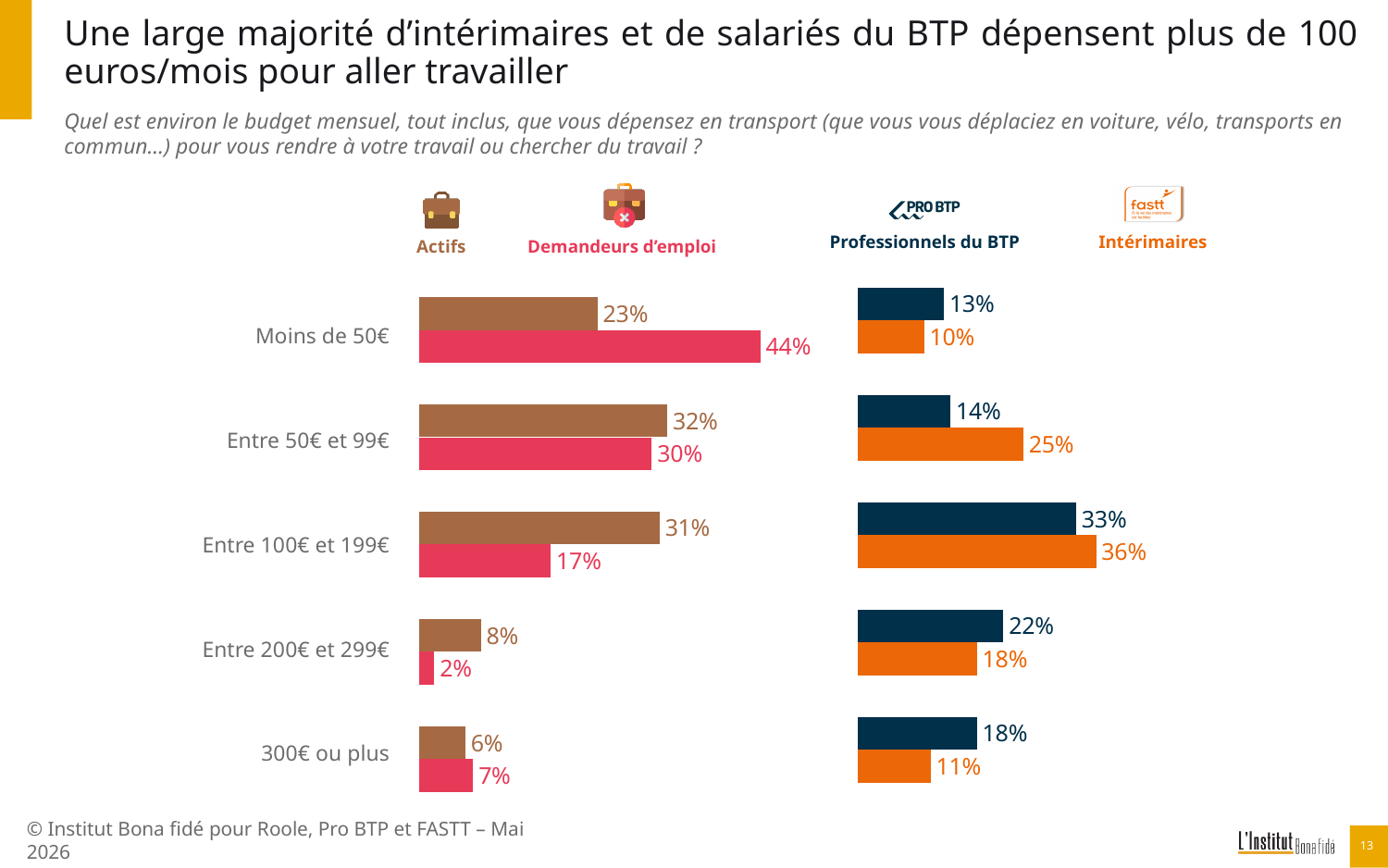
How many budget categories are shown on the slide's charts? 5 In the right chart (Professionnels du BTP / Intérimaires), which category has the highest value for Professionnels du BTP? Entre 100€ et 199€ In the left chart (Actifs / Demandeurs d'emploi), which category has the highest value for Demandeurs d'emploi? Moins de 50€ In the right chart (Professionnels du BTP / Intérimaires), what is the value for Intérimaires in the 'Entre 100€ et 199€' category? 36% In the right chart (Professionnels du BTP / Intérimaires), what is the difference between Intérimaires and Professionnels du BTP in the 'Entre 50€ et 99€' category? 11% In the left chart (Actifs / Demandeurs d'emploi), what is the value for Actifs in the 'Entre 50€ et 99€' category? 32% In the right chart (Professionnels du BTP / Intérimaires), what is the value for Professionnels du BTP in the '300€ ou plus' category? 18% What kind of chart is used on the slide? Bar chart In the left chart (Actifs / Demandeurs d'emploi), what is the value for Demandeurs d'emploi in the 'Moins de 50€' category? 44% In the left chart (Actifs / Demandeurs d'emploi), what is the difference between Actifs and Demandeurs d'emploi in the 'Entre 100€ et 199€' category? 14% In the left chart (Actifs / Demandeurs d'emploi), which category has the lowest value for Demandeurs d'emploi? Entre 200€ et 299€ In the right chart (Professionnels du BTP / Intérimaires), which is larger in the 'Entre 200€ et 299€' category: Professionnels du BTP or Intérimaires? Professionnels du BTP